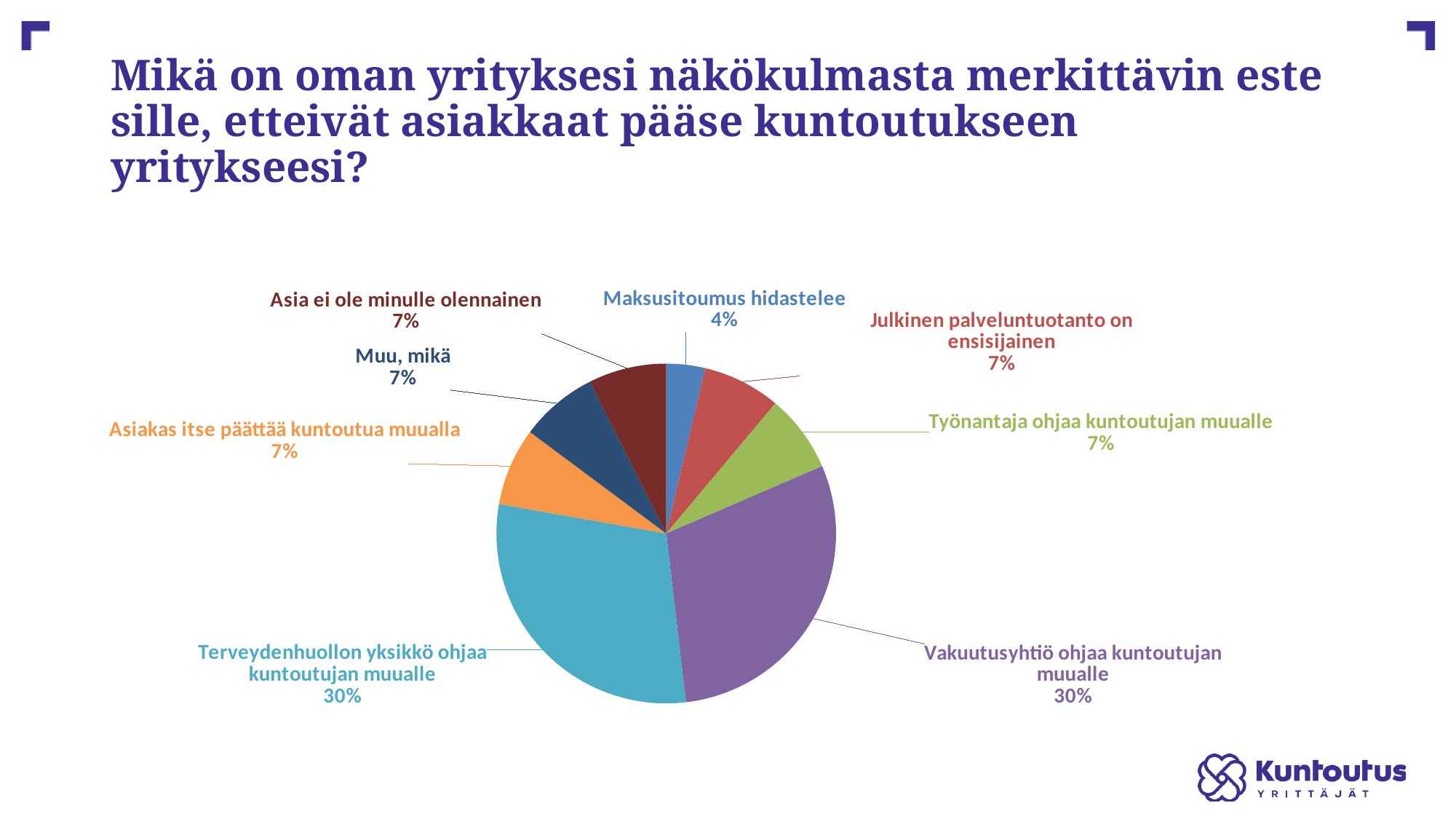
Which is larger: the share for "Työnantaja ohjaa kuntoutujan muualle" or the share for "Maksusitoumus hidastelee"? Työnantaja ohjaa kuntoutujan muualle What is the difference in percentage points between "Vakuutusyhtiö ohjaa kuntoutujan muualle" and "Maksusitoumus hidastelee"? 26 percentage points Which category has the smallest share of the pie? Maksusitoumus hidastelee What share of the pie is labelled "Julkinen palveluntuotanto on ensisijainen"? 7% What kind of chart is shown on the slide? pie chart How many slices does the pie chart have? 8 What share of the pie is labelled "Maksusitoumus hidastelee"? 4% Which two categories share the largest slices of the pie? Vakuutusyhtiö ohjaa kuntoutujan muualle and Terveydenhuollon yksikkö ohjaa kuntoutujan muualle How many categories in the pie chart have a share of 7%? 5 What share of the pie is labelled "Muu, mikä"? 7% What share of the pie is labelled "Terveydenhuollon yksikkö ohjaa kuntoutujan muualle"? 30% What share of the pie is labelled "Vakuutusyhtiö ohjaa kuntoutujan muualle"? 30%